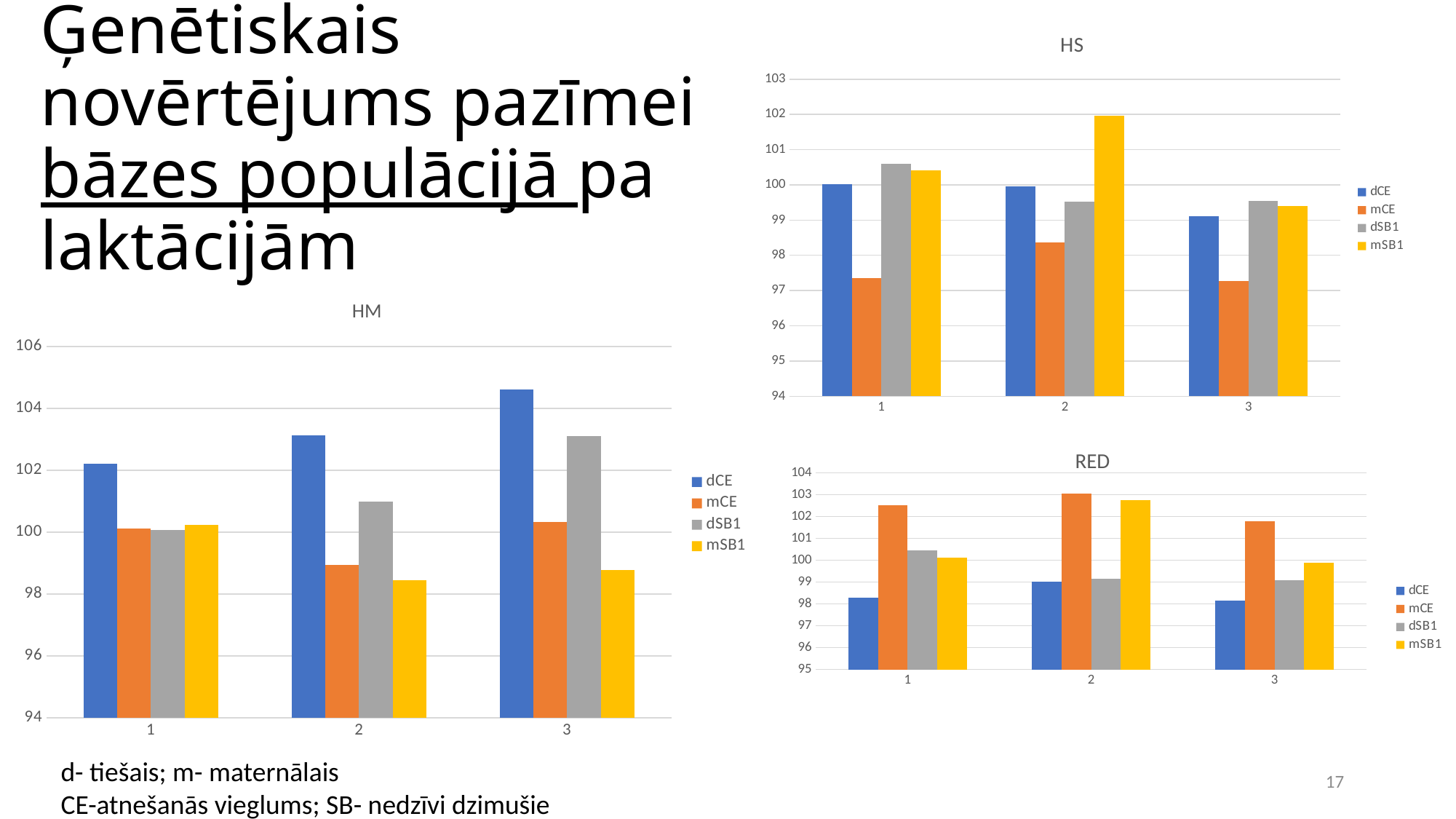
How many categories are shown on the x axis of the RED chart? 3 How many series does the legend of the HS chart list? 4 In the HS chart, is the value for mCE in category 2 greater or less than 99? less In the HM chart, is the value for dCE in category 3 greater or less than 104? greater In the HS chart, which series has the highest bar in category 2? mSB1 In the HM chart, does the dCE series rise or fall from category 1 to category 3? rise In the HM chart, which is larger in category 1: dCE or mCE? dCE In the HM chart, which series has the highest bar in category 3? dCE In the HM chart, is the value for mSB1 in category 2 greater or less than 100? less In the RED chart, which is larger in category 2: mCE or dCE? mCE What kind of chart is the HM chart? bar chart